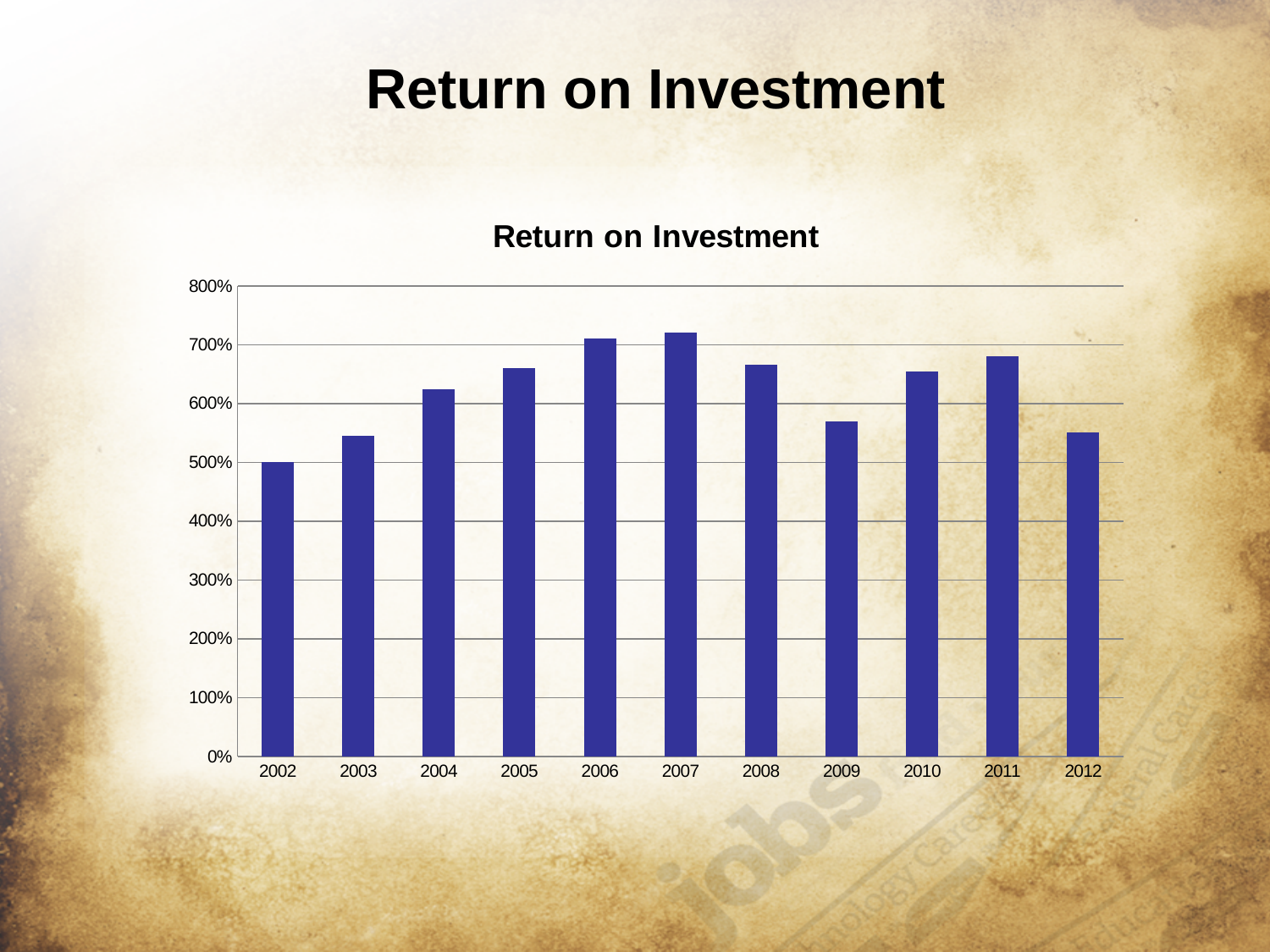
Is the value for 2003 greater or less than 600%? less Do the values rise or fall from 2002 to 2007? rise What is the title of the chart? Return on Investment Is the value for 2004 greater or less than 600%? greater Is the value for 2012 greater or less than 500%? greater How many years are plotted on the x axis? 11 Which is larger, the value for 2004 or the value for 2009? 2004 What kind of chart is shown on the slide? bar chart Which is larger, the value for 2011 or the value for 2012? 2011 Which year has the lowest return on investment? 2002